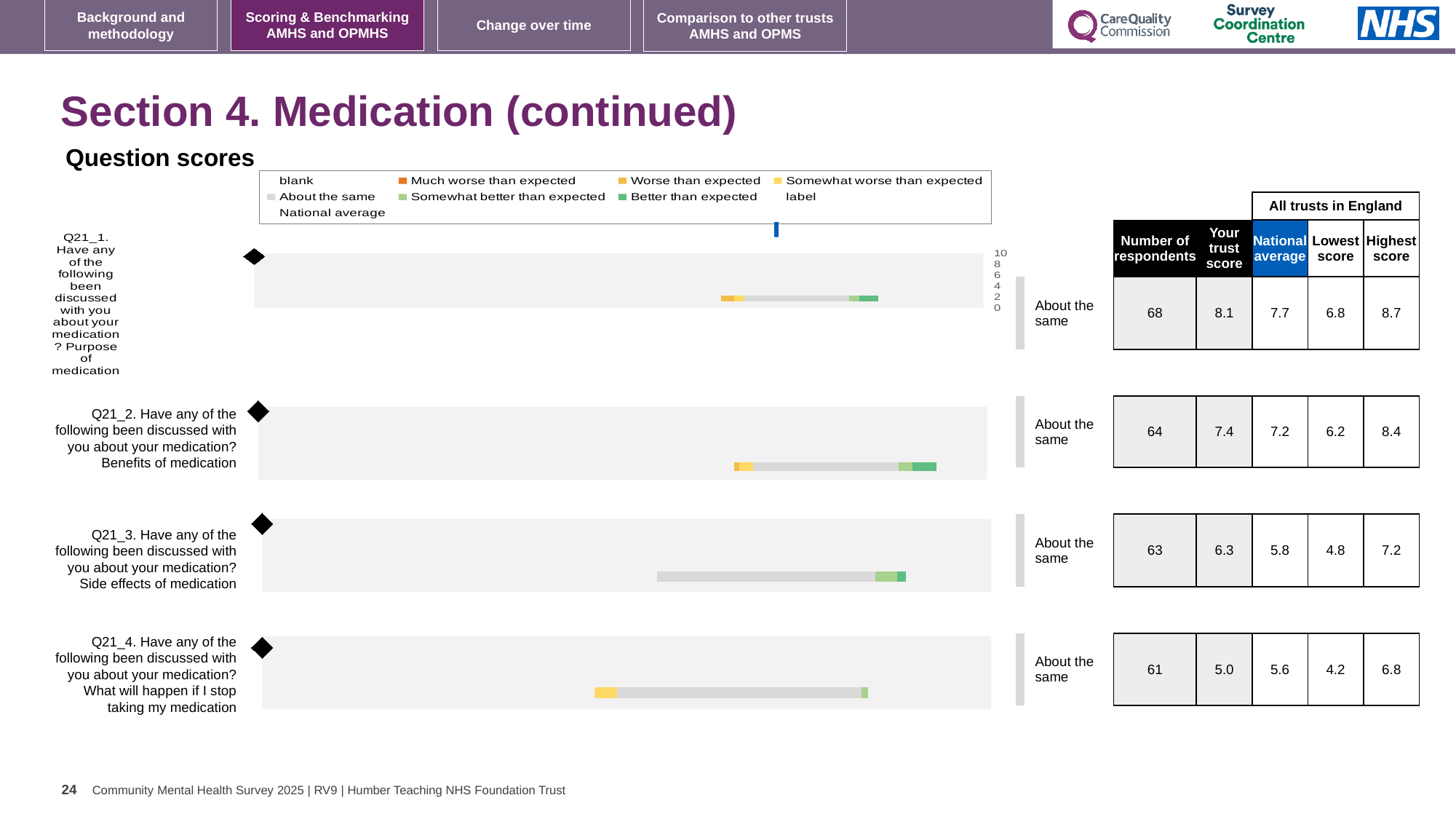
How many questions (Q21_1 to Q21_4) have a score bar plotted on this slide? 4 What is the National average for Q21_3 (Side effects of medication)? 5.8 For Q21_4, which is larger: the trust score or the National average? National average What kind of chart is used to show the question scores on this slide? bar chart For Q21_1, what is the difference between the trust score and the National average? 0.4 Which question has the lowest 'Your trust score' on this slide? Q21_4 (What will happen if I stop taking my medication) How many respondents are recorded for Q21_1 (Purpose of medication)? 68 What is the Lowest score among all trusts in England for Q21_4? 4.2 What benchmark label is shown next to the bar for Q21_3 (Side effects of medication)? About the same What is the 'Your trust score' value for Q21_2 (Benefits of medication)? 7.4 Which question has the highest 'Your trust score' on this slide? Q21_1 (Purpose of medication) What is the Highest score among all trusts in England for Q21_2 (Benefits of medication)? 8.4